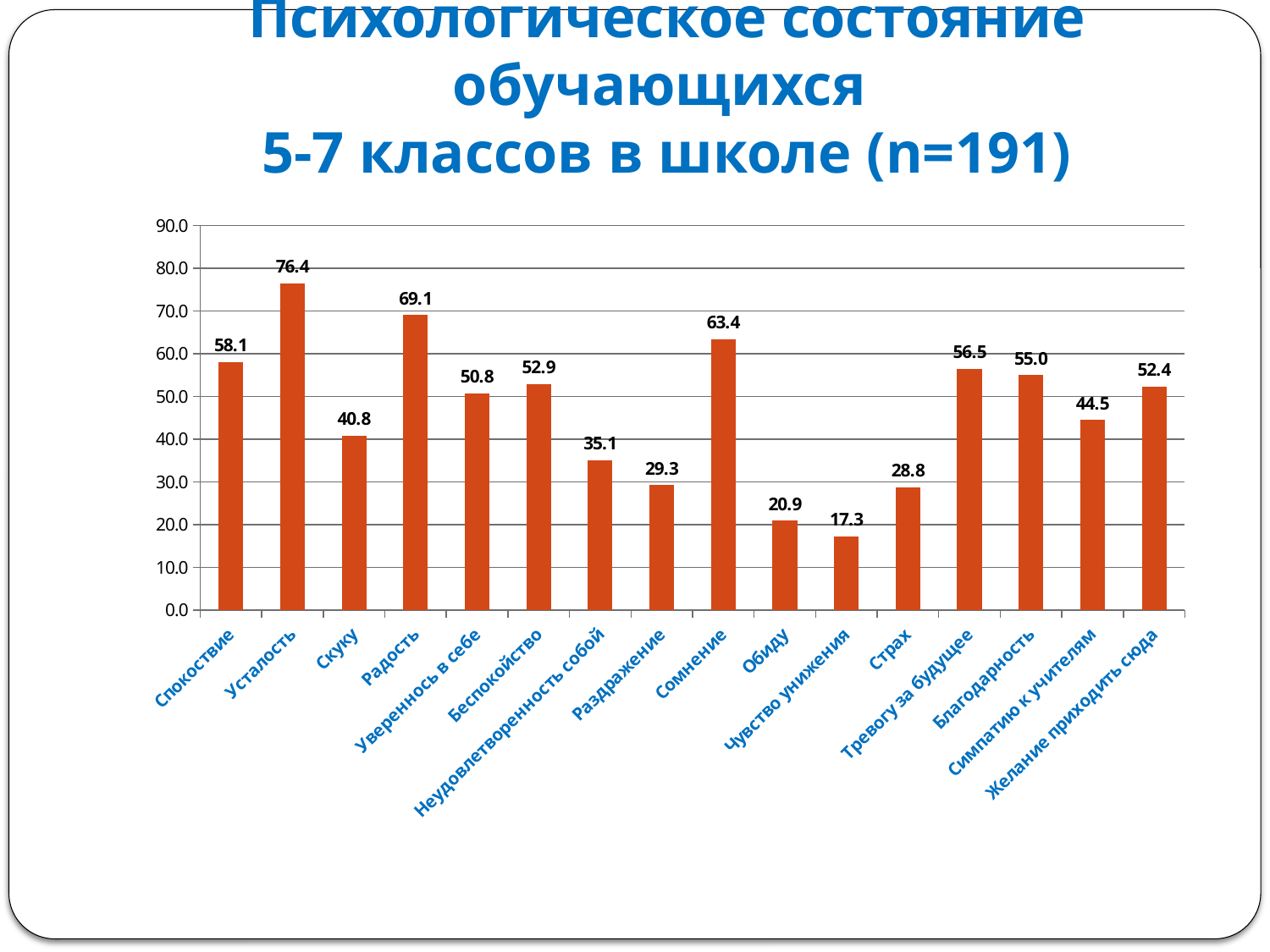
What is the difference between the values for Тревогу за будущее and Страх? 27.7 Which is larger, the value for Спокоствие or the value for Благодарность? Спокоствие What kind of chart is shown on the slide? bar chart Which category has the lowest value? Чувство унижения Which category has the highest value? Усталость Is the value for Обиду greater or less than 30.0? less What is the difference between the values for Радость and Скуку? 28.3 What sample size (n) is given in the slide title? 191 What is the value for Симпатию к учителям? 44.5 How many categories are shown on the x axis? 16 What is the value for Усталость? 76.4 What is the value for Сомнение? 63.4